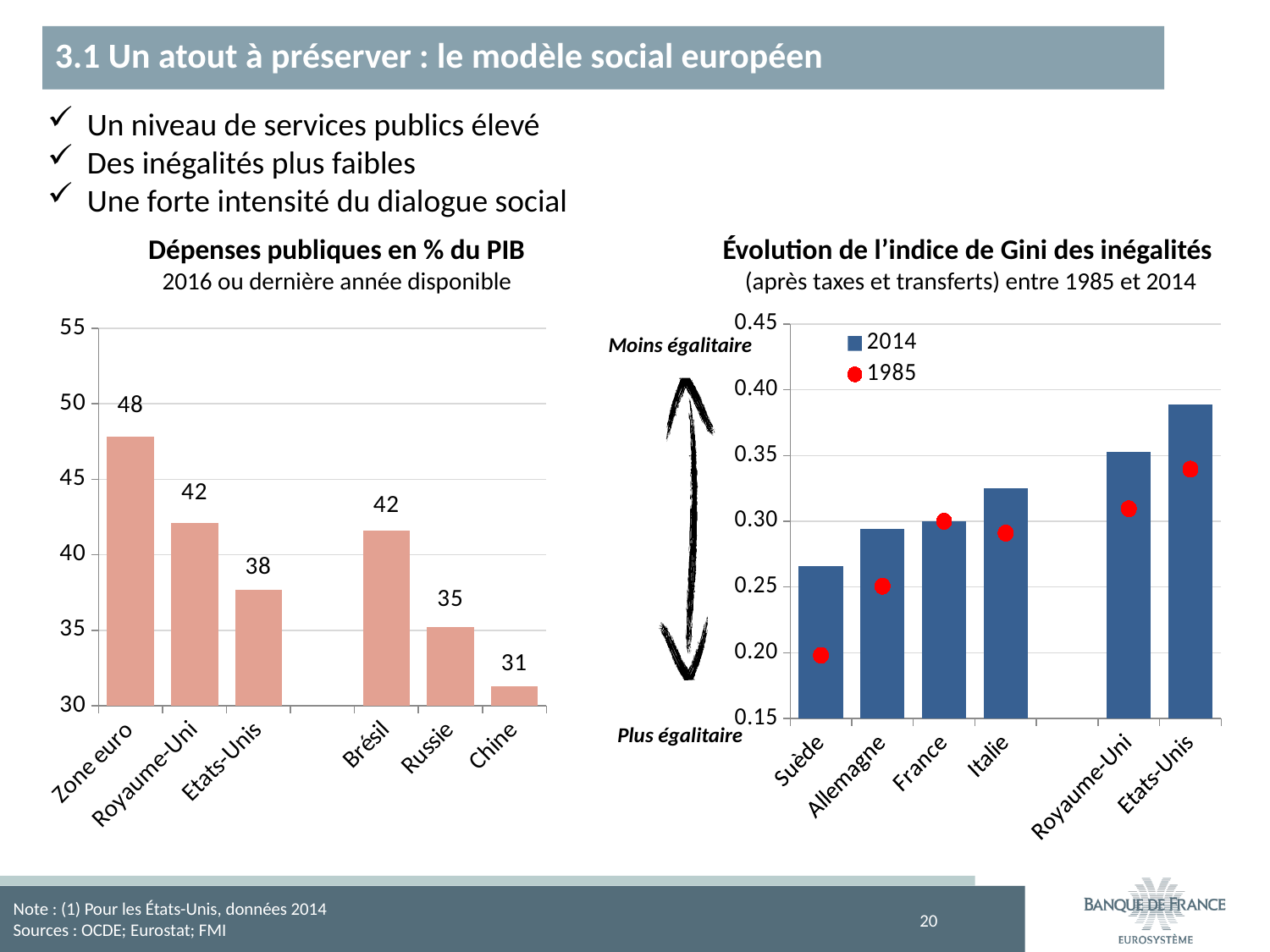
How many categories are shown in the chart 'Dépenses publiques en % du PIB'? 6 In the chart 'Évolution de l'indice de Gini des inégalités', is the 2014 value for Etats-Unis greater or less than 0.35? greater In the chart 'Dépenses publiques en % du PIB', what is the value for Zone euro? 48 How many series does the legend list in the chart 'Évolution de l'indice de Gini des inégalités'? 2 In the chart 'Dépenses publiques en % du PIB', what is the difference between the values for Zone euro and Chine? 17 In the chart 'Dépenses publiques en % du PIB', which is larger, the value for Royaume-Uni or the value for Russie? Royaume-Uni In the chart 'Dépenses publiques en % du PIB', which category has the highest value? Zone euro In the chart 'Dépenses publiques en % du PIB', which category has the lowest value? Chine In the chart 'Évolution de l'indice de Gini des inégalités', is the 1985 value for Allemagne greater or less than 0.30? less In the chart 'Évolution de l'indice de Gini des inégalités', which country has the highest 2014 value? Etats-Unis What kind of chart is 'Dépenses publiques en % du PIB'? bar chart In the chart 'Dépenses publiques en % du PIB', what is the value for Chine? 31